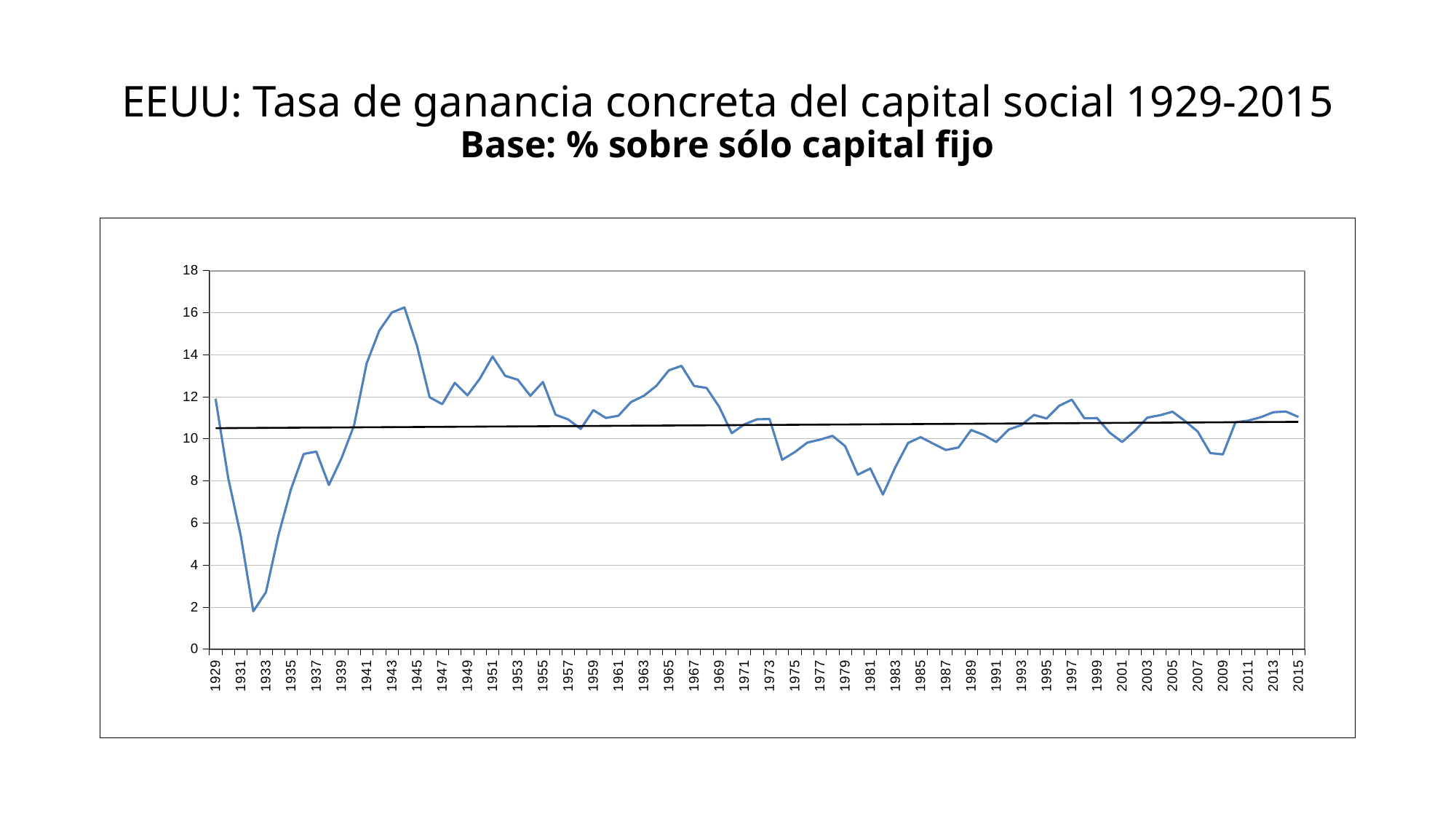
In which year does the blue line reach its highest value? 1944 What kind of chart is shown on the slide? line chart In which year does the blue line reach its lowest value? 1932 What is the highest value shown on the vertical axis? 18 Does the blue line rise or fall between 1929 and 1932? falls Is the value for 1932 greater or less than 4? less Is the value for 1982 greater or less than 8? less Is the value for 2009 greater or less than 10? less Which year has the larger value, 1932 or 1982? 1982 Which year has the larger value, 1944 or 1951? 1944